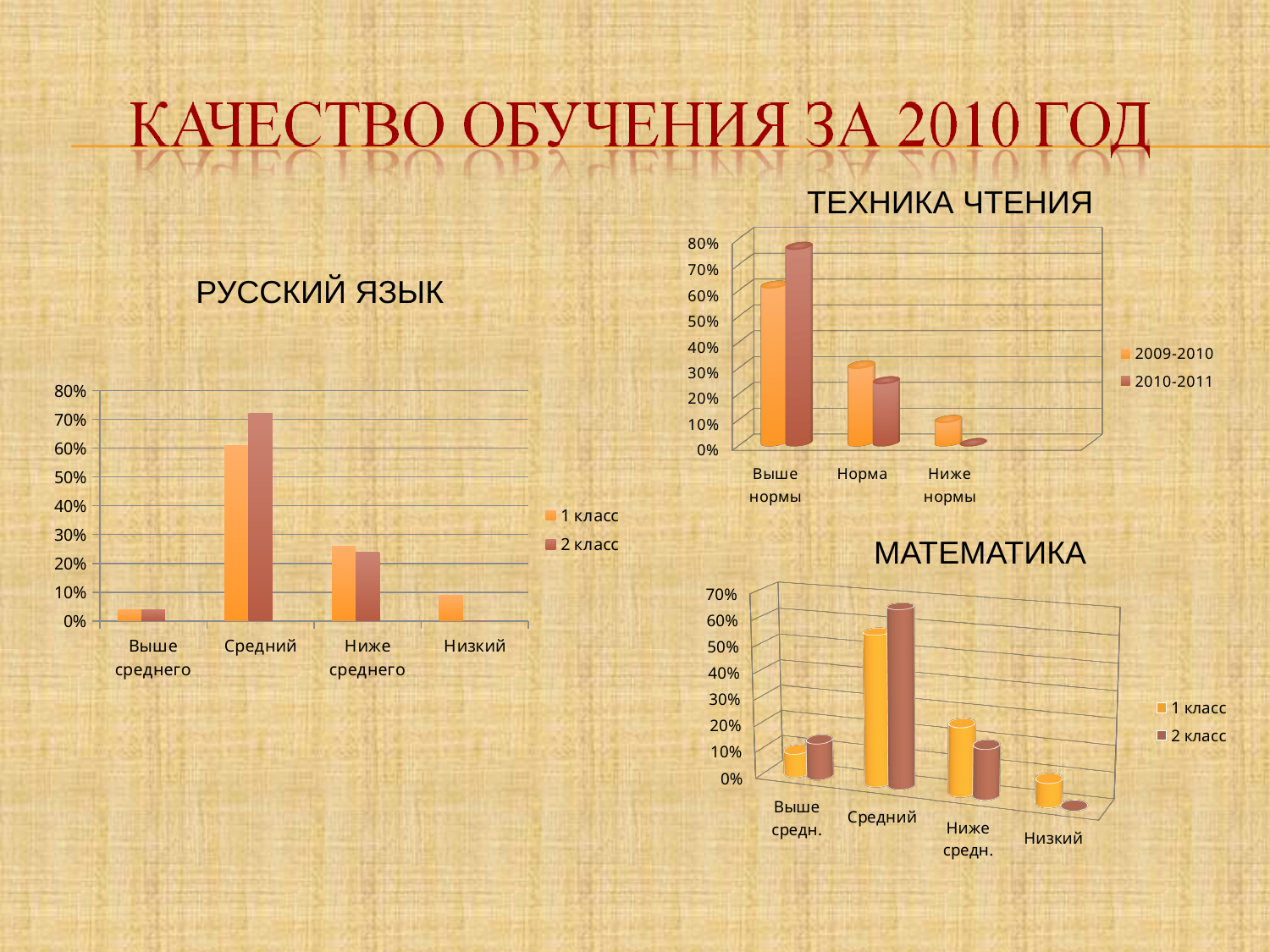
On the ТЕХНИКА ЧТЕНИЯ chart, what are the two series listed in the legend? 2009-2010 and 2010-2011 On the РУССКИЙ ЯЗЫК chart, in the Средний category, which series has the larger value, 1 класс or 2 класс? 2 класс On the РУССКИЙ ЯЗЫК chart, how many categories are shown on the x axis? 4 On the ТЕХНИКА ЧТЕНИЯ chart, how many categories are shown on the x axis? 3 On the ТЕХНИКА ЧТЕНИЯ chart, which category has the lowest value for 2010-2011? Ниже нормы On the РУССКИЙ ЯЗЫК chart, is the value for 1 класс in the Средний category greater or less than 50%? greater On the РУССКИЙ ЯЗЫК chart, how many series does the legend list? 2 On the ТЕХНИКА ЧТЕНИЯ chart, is the value for 2010-2011 in the Выше нормы category greater or less than 70%? greater On the МАТЕМАТИКА chart, which category has the highest value for 1 класс? Средний What kind of chart is the МАТЕМАТИКА chart? Bar chart On the РУССКИЙ ЯЗЫК chart, which category has the highest value for 2 класс? Средний On the МАТЕМАТИКА chart, in the Ниже средн. category, which series has the larger value, 1 класс or 2 класс? 1 класс